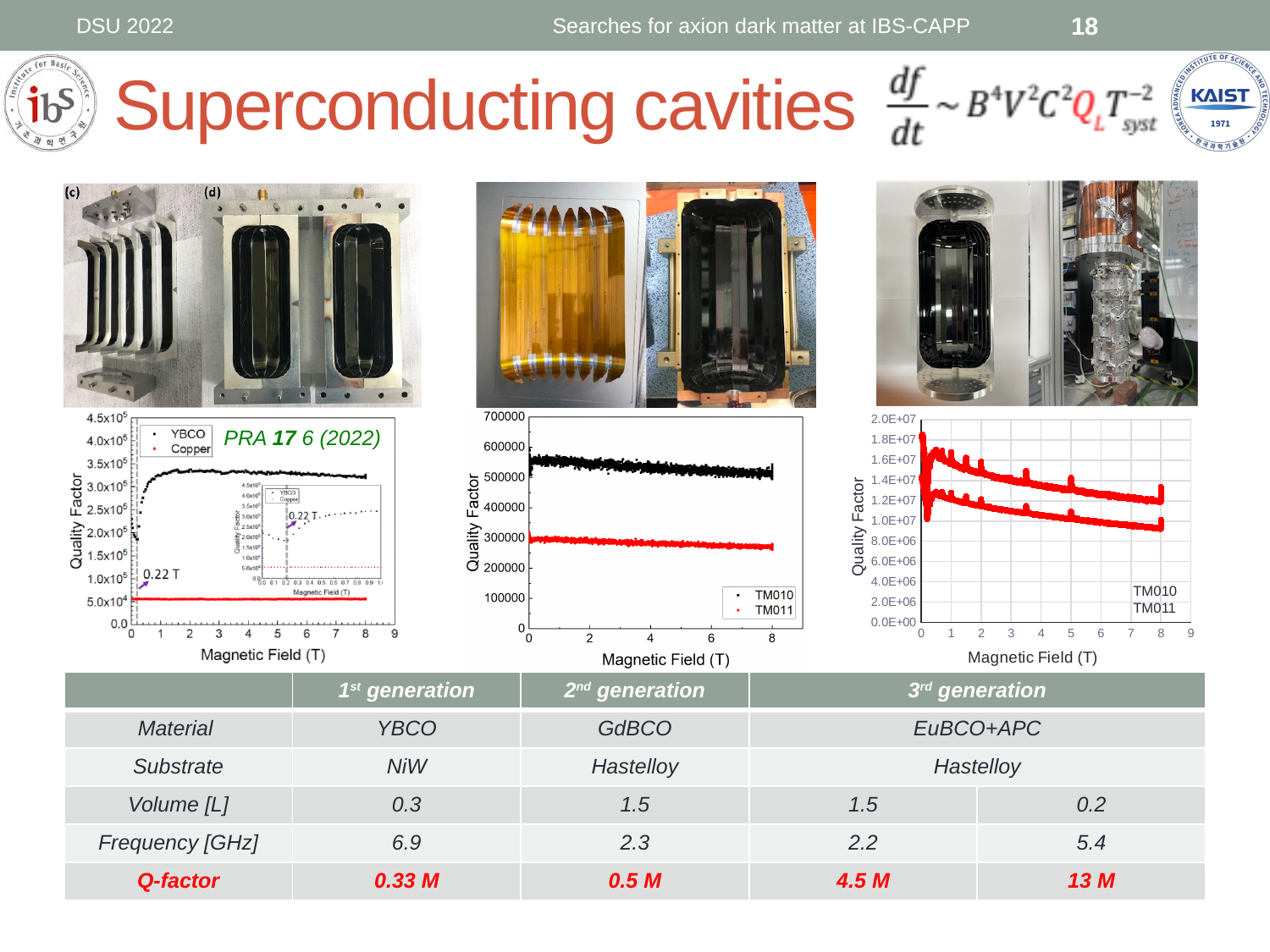
In the left chart, is the quality factor of YBCO at 4 T greater or less than 2.5x10^5? greater In the right chart, does the quality factor of TM010 rise or fall as the magnetic field increases from 0 to 8 T? fall How many series does the legend of the right chart list? 2 In the middle chart, which series has the higher quality factor, TM010 or TM011? TM010 In the left chart, which series has the higher quality factor, YBCO or Copper? YBCO In the middle chart, does the quality factor of TM010 rise or fall as the magnetic field increases? fall How many series does the legend of the left chart list? 2 What kind of chart is the left chart (YBCO vs Copper)? scatter plot In the middle chart, is the quality factor of TM011 greater or less than 400000? less In the left chart, is the quality factor of Copper greater or less than 1.0x10^5? less What is the x-axis label of the middle chart? Magnetic Field (T)